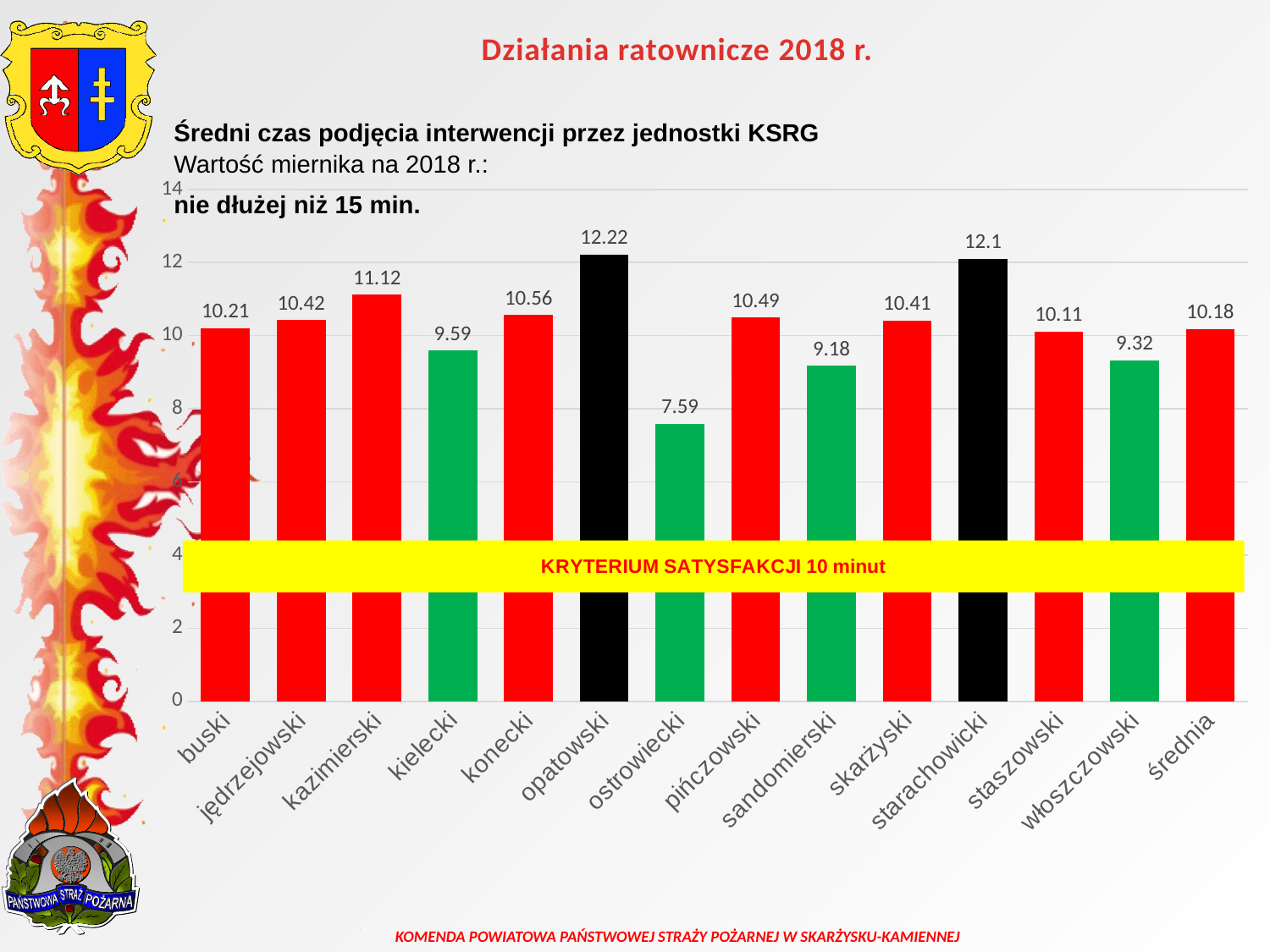
What is the value shown for średnia? 10.18 Which category has the lowest value? ostrowiecki What kind of chart is shown on the slide? bar chart What text is written on the yellow band across the chart? KRYTERIUM SATYSFAKCJI 10 minut Which is larger, the value for kazimierski or the value for konecki? kazimierski What is the value for skarżyski? 10.41 What is the value for ostrowiecki? 7.59 How many categories are shown on the x axis? 14 What is the difference between the values for opatowski and ostrowiecki? 4.63 Which category has the highest value? opatowski What is the value for opatowski? 12.22 Is the value for sandomierski greater or less than 10? less